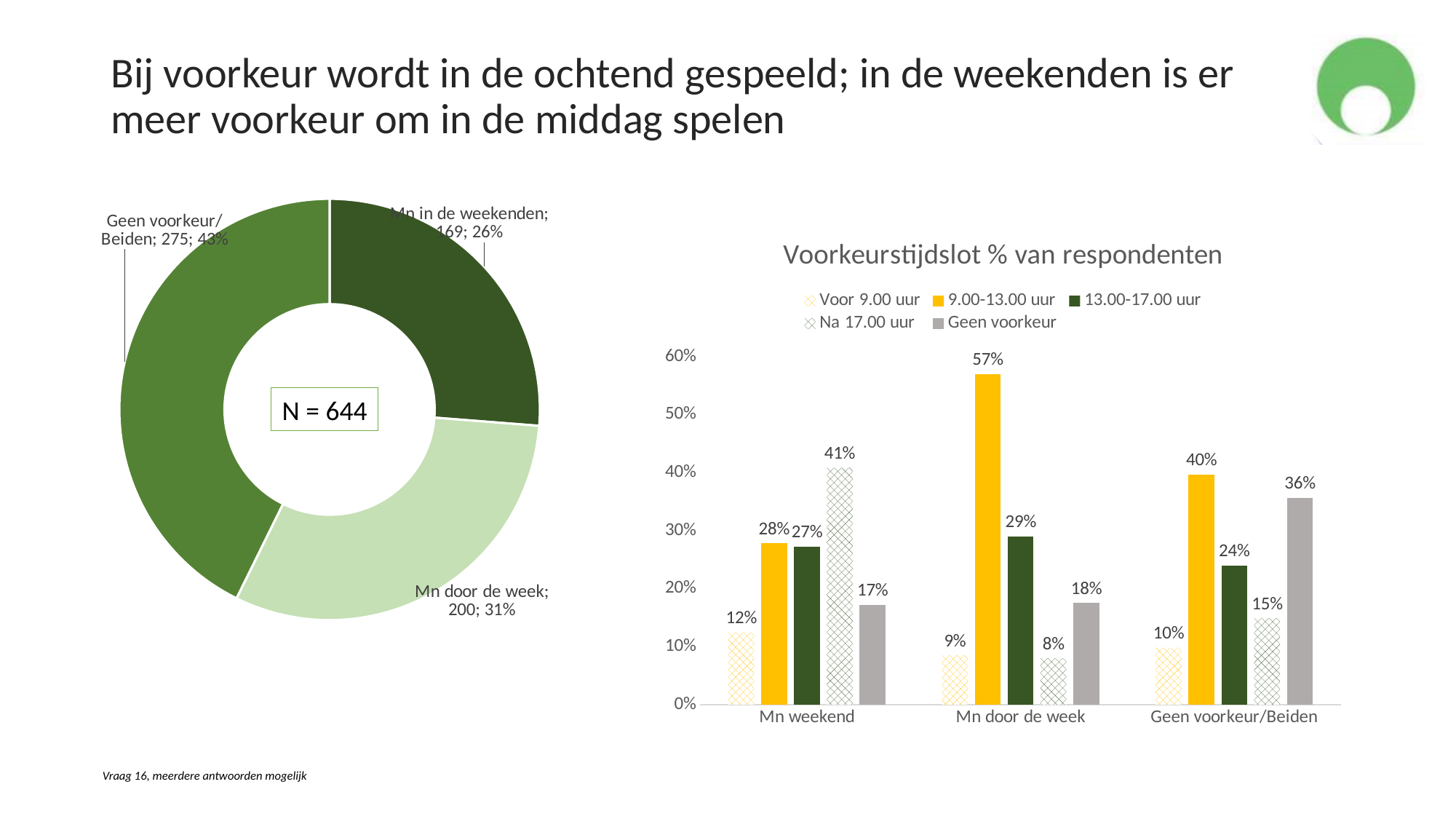
In the donut chart on the left, which category has the smallest count? Mn in de weekenden In the chart 'Voorkeurstijdslot % van respondenten', what is the value for 'Na 17.00 uur' in the 'Mn weekend' category? 41% In the donut chart on the left, what is the difference in count between 'Geen voorkeur/Beiden' and 'Mn in de weekenden'? 106 In the donut chart on the left, what is the total N shown in the centre? N = 644 In the chart 'Voorkeurstijdslot % van respondenten', which is larger for 'Geen voorkeur/Beiden': '9.00-13.00 uur' or 'Geen voorkeur'? 9.00-13.00 uur In the chart 'Voorkeurstijdslot % van respondenten', what is the value for '9.00-13.00 uur' in the 'Mn door de week' category? 57% In the chart 'Voorkeurstijdslot % van respondenten', how many series does the legend list? 5 In the chart 'Voorkeurstijdslot % van respondenten', which series has the lowest value in the 'Mn door de week' category? Na 17.00 uur In the donut chart on the left, what share of respondents chose 'Geen voorkeur/Beiden'? 43% In the donut chart on the left, how many respondents chose 'Mn door de week'? 200 In the chart 'Voorkeurstijdslot % van respondenten', what is the difference between '13.00-17.00 uur' for 'Mn door de week' and for 'Geen voorkeur/Beiden'? 5% What kind of chart is 'Voorkeurstijdslot % van respondenten'? Bar chart